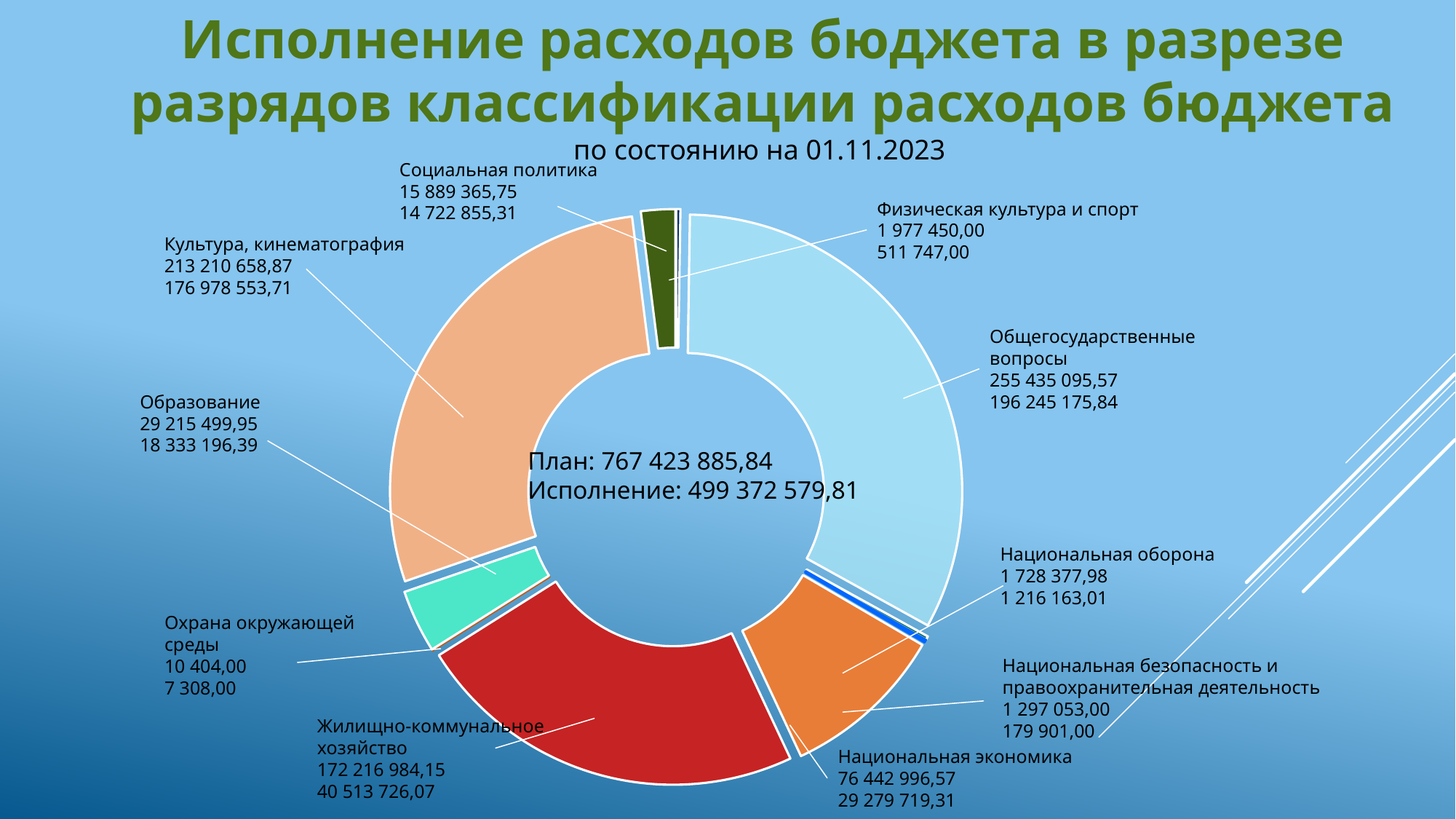
Which has the larger first (plan) value: Культура, кинематография or Жилищно-коммунальное хозяйство? Культура, кинематография What is the first value shown for Охрана окружающей среды? 10 404,00 What is the second (execution) value shown for Жилищно-коммунальное хозяйство? 40 513 726,07 Which category has the largest slice in the chart? Общегосударственные вопросы What kind of chart is shown on the slide? Doughnut (pie) chart What total execution value (Исполнение) is printed in the centre of the chart? 499 372 579,81 What is the second value shown for Физическая культура и спорт? 511 747,00 How many categories (slices) does the chart show? 10 What is the first (plan) value shown for Общегосударственные вопросы? 255 435 095,57 What total plan value (План) is printed in the centre of the chart? 767 423 885,84 What is the difference between the first and second values shown for Социальная политика? 1 166 510,44 Which category has the smallest slice in the chart? Охрана окружающей среды